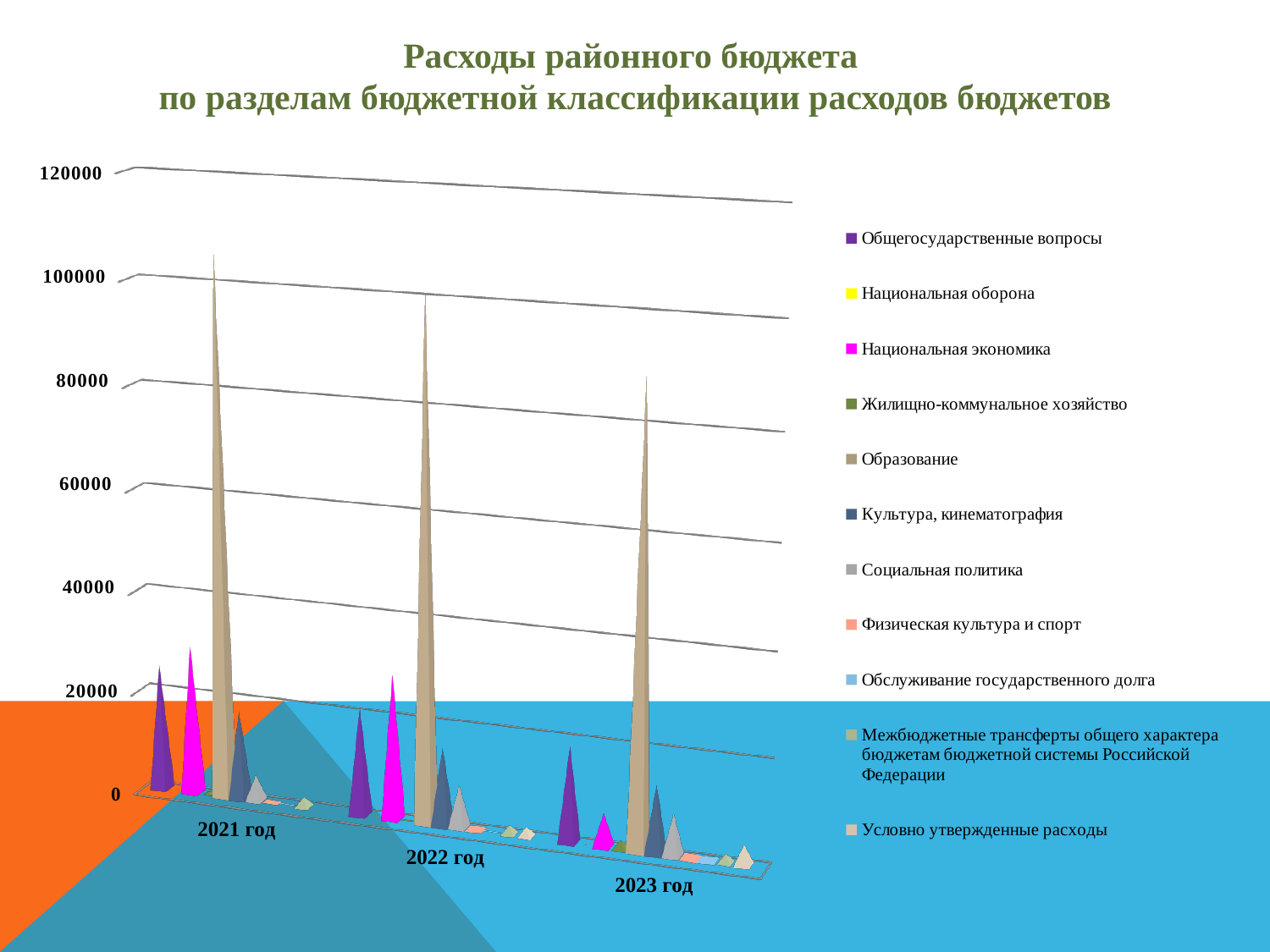
Which is larger in 2021 год: Образование or Общегосударственные вопросы? Образование In which year is the value for Образование the highest? 2021 год Which series has the highest value in 2021 год? Образование In which year is the value for Образование the lowest? 2023 год What kind of chart is shown on the slide? bar chart Does the value for Образование rise or fall from 2021 год to 2023 год? fall Is the value for Национальная экономика in 2021 год greater or less than 40000? less Is the value for Образование in 2023 год greater or less than 60000? greater Is the value for Образование in 2021 год greater or less than 80000? greater How many series does the legend list? 11 How many year categories are shown on the x axis? 3 What colour represents Национальная экономика in the legend? magenta